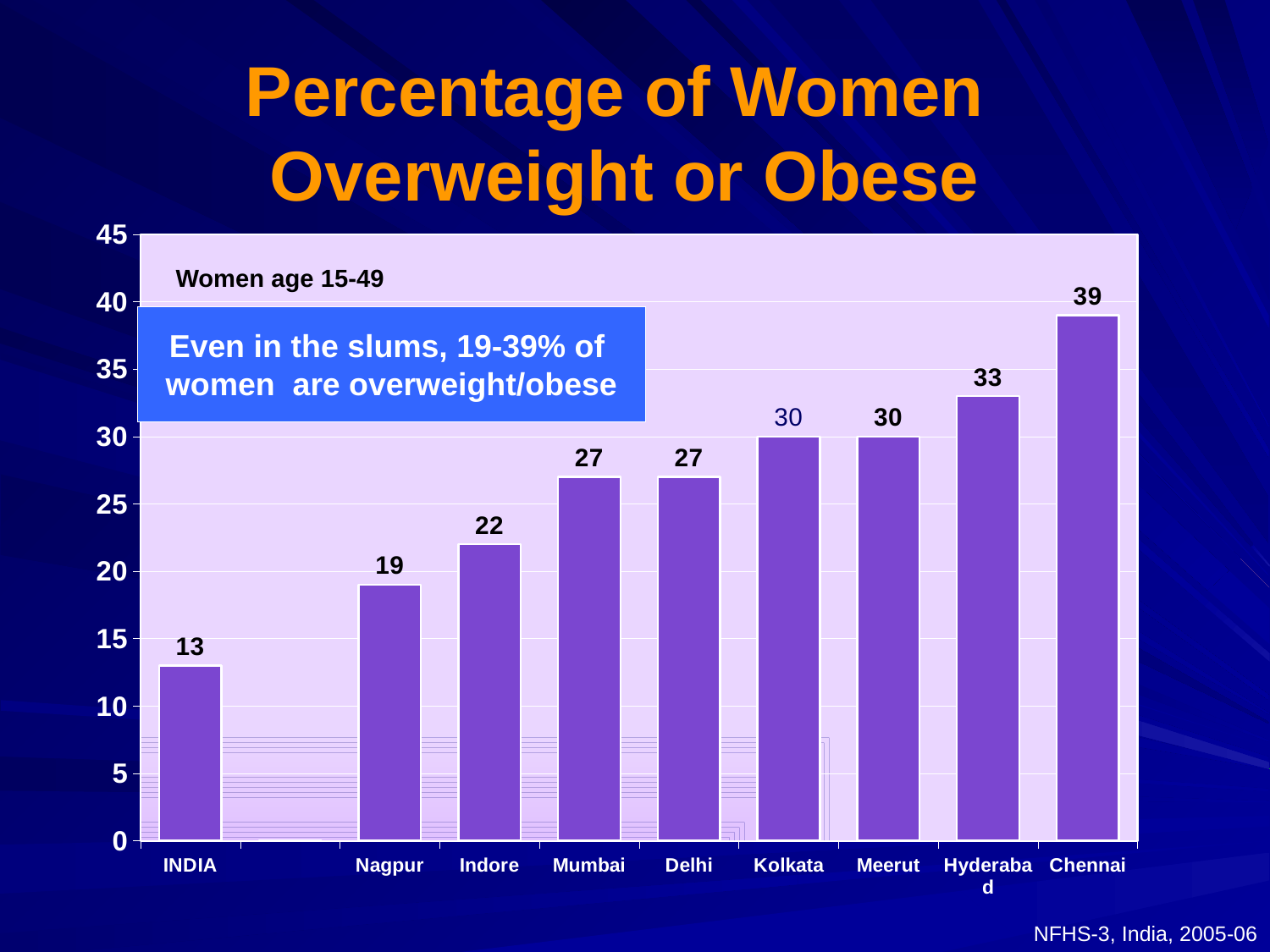
What is the value for Chennai? 39 Which category has the highest value? Chennai How many bars are shown in the chart? 9 What is the value for Nagpur? 19 Which is larger, the value for Meerut or the value for Mumbai? Meerut What is the title of the chart? Percentage of Women Overweight or Obese What is the value for Hyderabad? 33 What is the difference between the values for Chennai and INDIA? 26 Which category has the lowest value? INDIA What is the difference between the values for Hyderabad and Indore? 11 What kind of chart is shown on the slide? Bar chart What is the value for INDIA? 13